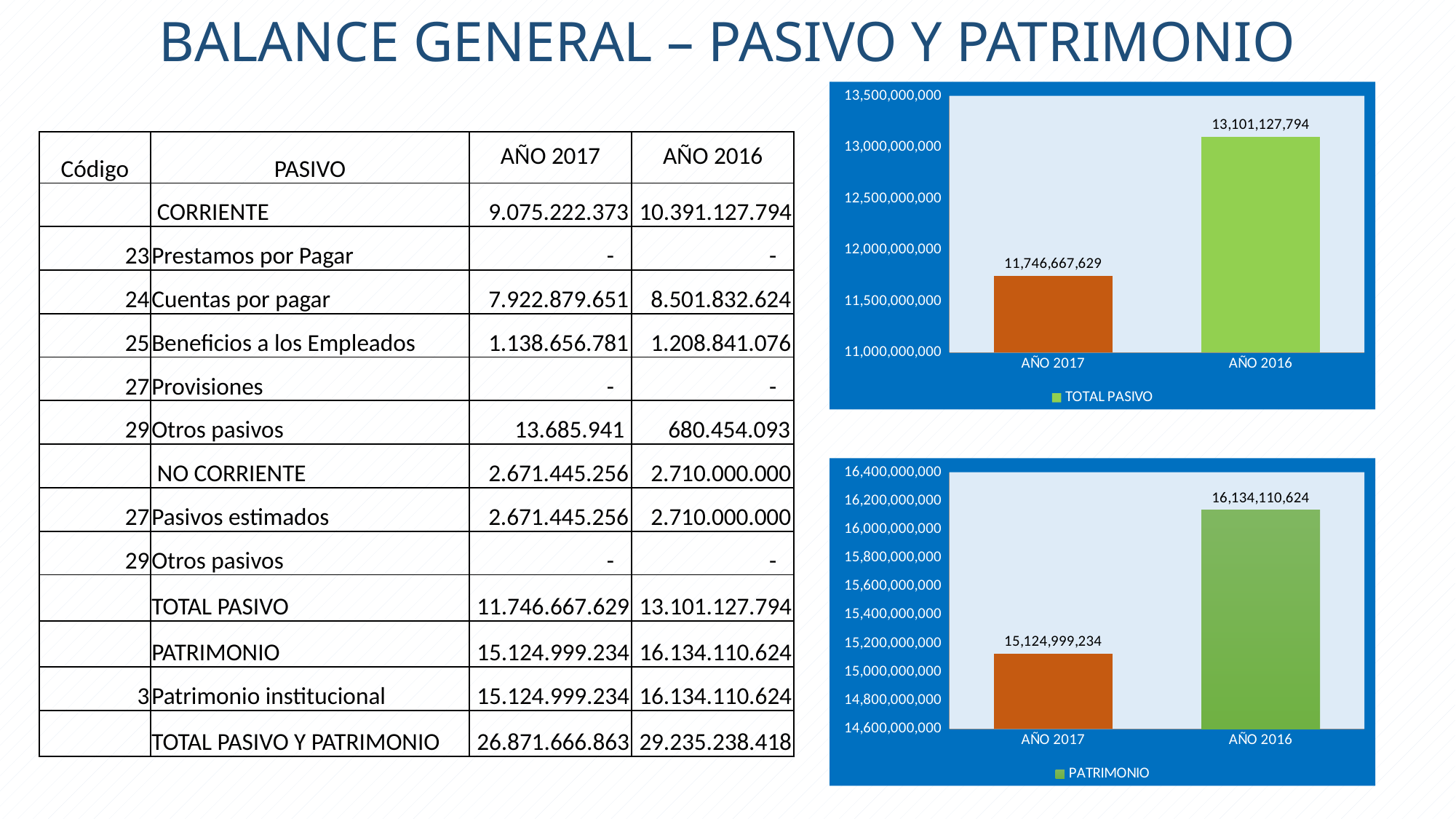
What kind of chart is the top chart (TOTAL PASIVO)? bar chart In the bottom chart (PATRIMONIO), what is the value for AÑO 2017? 15,124,999,234 In the bottom chart (PATRIMONIO), is the value for AÑO 2016 greater or less than 16,000,000,000? greater In the bottom chart (PATRIMONIO), which year has the lower value? AÑO 2017 In the top chart (TOTAL PASIVO), what is the difference between the AÑO 2016 and AÑO 2017 values? 1,354,460,165 How many categories are shown on the x axis of the bottom chart (PATRIMONIO)? 2 In the top chart (TOTAL PASIVO), which year has the higher value? AÑO 2016 In the bottom chart (PATRIMONIO), what is the value for AÑO 2016? 16,134,110,624 In the top chart (TOTAL PASIVO), what is the value for AÑO 2016? 13,101,127,794 In the top chart (TOTAL PASIVO), is the value for AÑO 2017 greater or less than 12,000,000,000? less In the top chart (TOTAL PASIVO), what is the value for AÑO 2017? 11,746,667,629 In the bottom chart (PATRIMONIO), what is the difference between the AÑO 2016 and AÑO 2017 values? 1,009,111,390